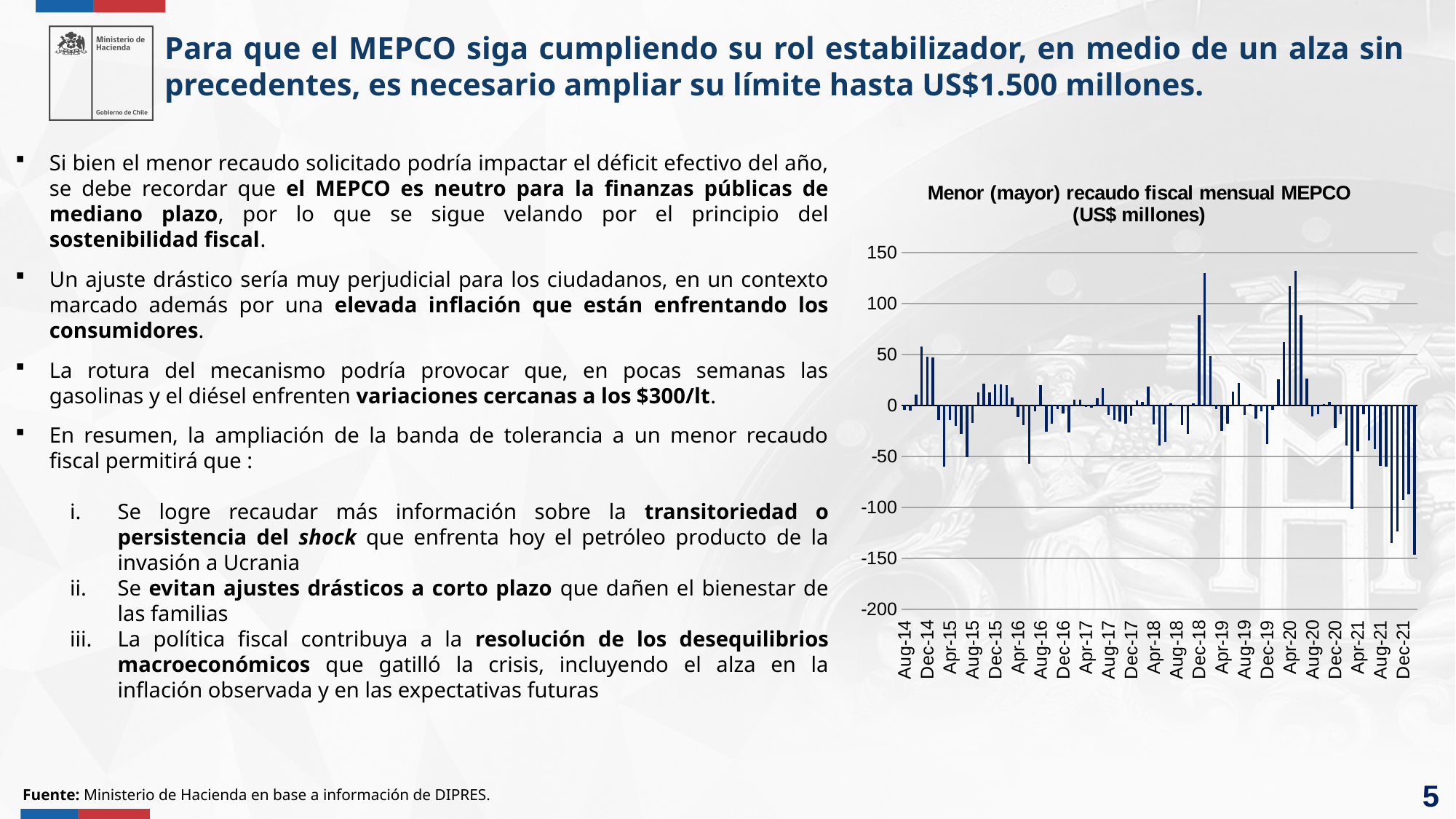
Which is larger, the value for Aug-14 or the value for Dec-21? Aug-14 Is the value for Aug-14 greater or less than 50? less Are the values in the last months of the series (late 2021) positive or negative? negative Do the values rise or fall from Apr-21 to Dec-21? fall What kind of chart is shown on the slide? bar chart What is the title of the chart? Menor (mayor) recaudo fiscal mensual MEPCO (US$ millones) What colour are the bars in the chart? dark blue